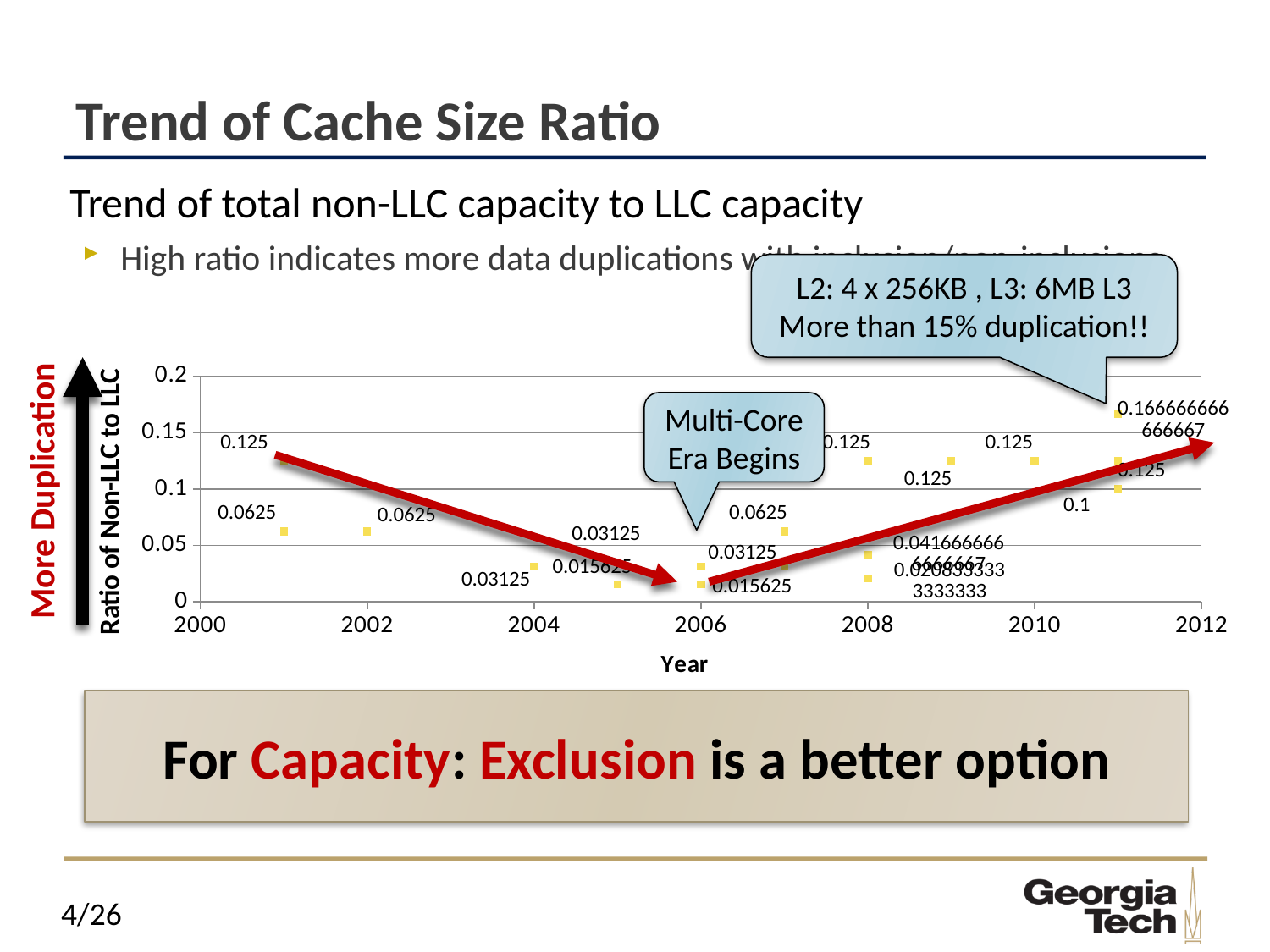
What is the lowest ratio value labeled on the chart? 0.015625 What is the ratio value plotted for the year 2004? 0.03125 Which year has the larger plotted ratio, 2002 or 2004? 2002 What is the difference between the ratio for 2002 and the ratio for 2004? 0.03125 What is the title of the x axis of the chart? Year What kind of chart is shown on the slide? scatter chart What is the ratio value plotted for the year 2009? 0.125 What is the highest ratio value labeled on the chart? 0.166666666666667 What is the ratio value plotted for the year 2010? 0.125 What is the title of the y axis of the chart? Ratio of Non-LLC to LLC Is the highest point plotted for 2011 greater or less than 0.15? greater What is the ratio value plotted for the year 2002? 0.0625